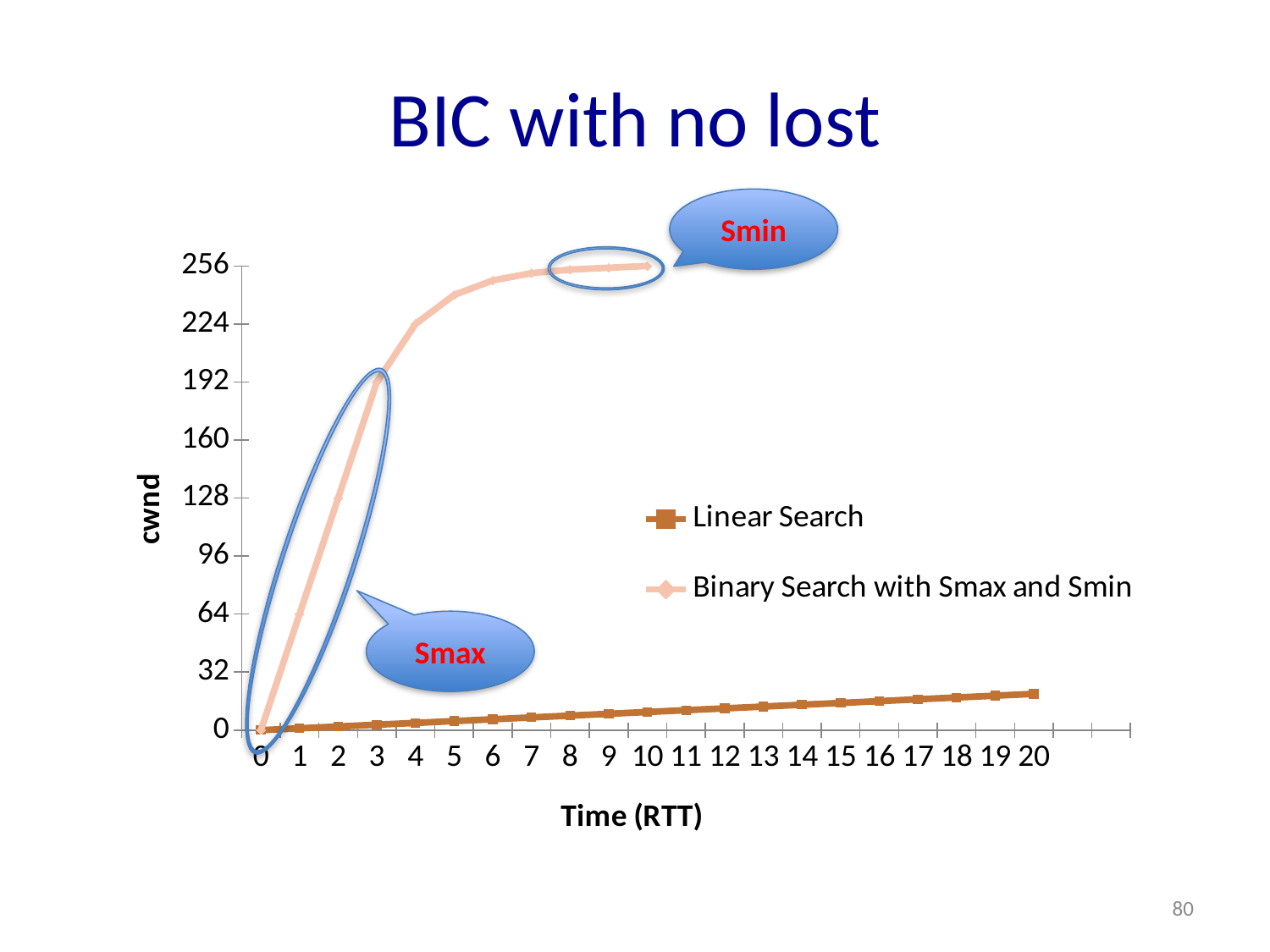
What is the cwnd value of the Binary Search with Smax and Smin series at time 3? 192 What is the cwnd value of the Binary Search with Smax and Smin series at time 1? 64 At time 10, which series has the higher cwnd value? Binary Search with Smax and Smin Is the cwnd value of the Linear Search series at time 20 greater or less than 32? less How many time values are labelled on the x axis? 21 Does the Linear Search series rise or fall as time increases? rise What kind of chart is shown on the slide? line chart What is the label of the x axis? Time (RTT) How many series does the legend list? 2 What is the cwnd value of the Binary Search with Smax and Smin series at time 2? 128 Is the cwnd value of the Binary Search with Smax and Smin series at time 5 greater or less than 224? greater What is the title of the chart? BIC with no lost